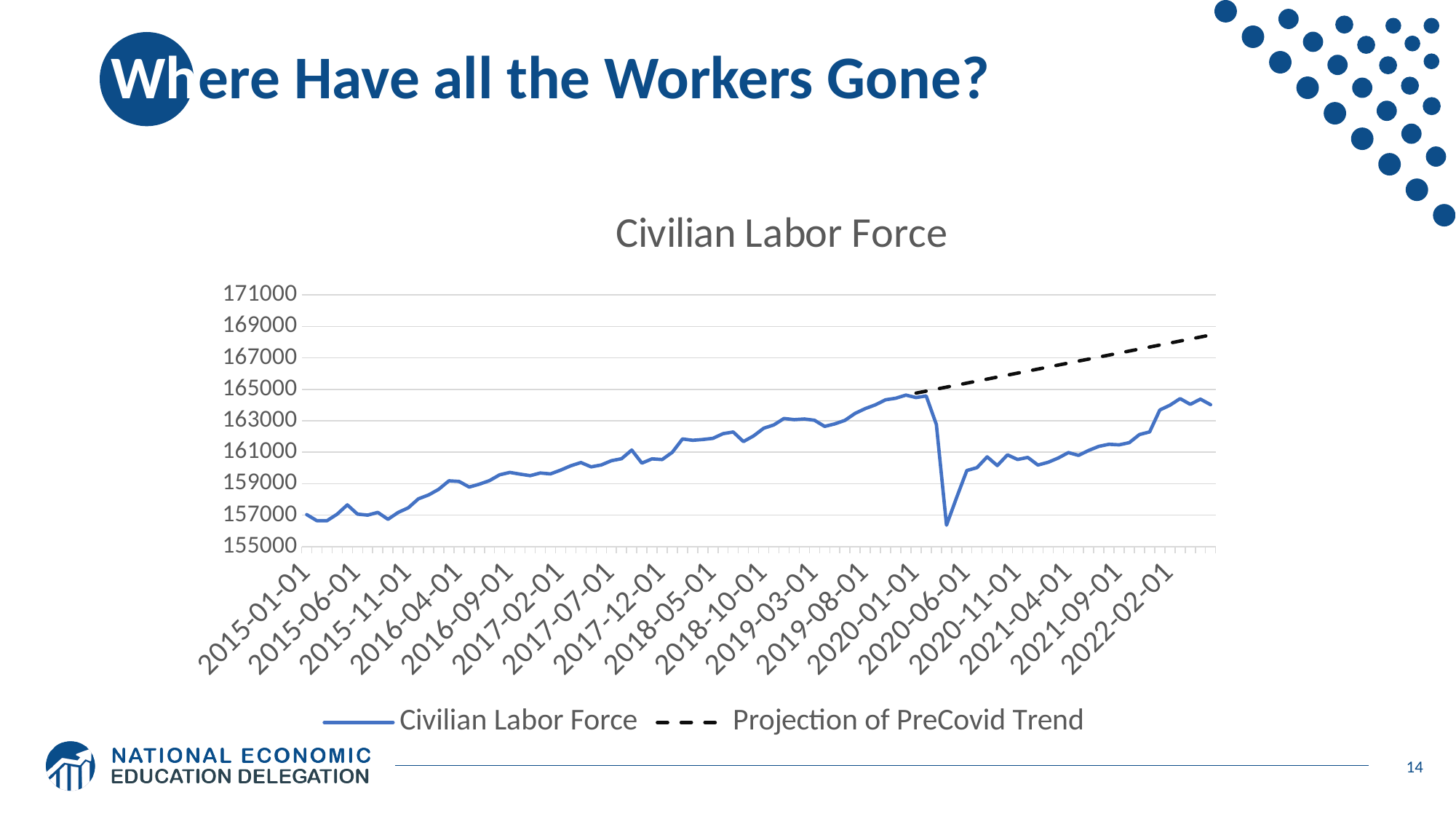
Which series is drawn as a dashed line? Projection of PreCovid Trend Does the Civilian Labor Force line generally rise or fall between 2015-01-01 and 2020-01-01? rise How many series does the legend list? 2 At the right end of the chart, which series is higher: Civilian Labor Force or Projection of PreCovid Trend? Projection of PreCovid Trend What kind of chart is shown on the slide? line chart Is the final value of the Projection of PreCovid Trend line greater or less than 167000? greater How many date labels are shown on the x axis? 18 Is the value of the Civilian Labor Force line at 2017-02-01 greater or less than 161000? less Is the value of the Civilian Labor Force line at 2019-03-01 greater or less than 161000? greater What is the title of the chart? Civilian Labor Force